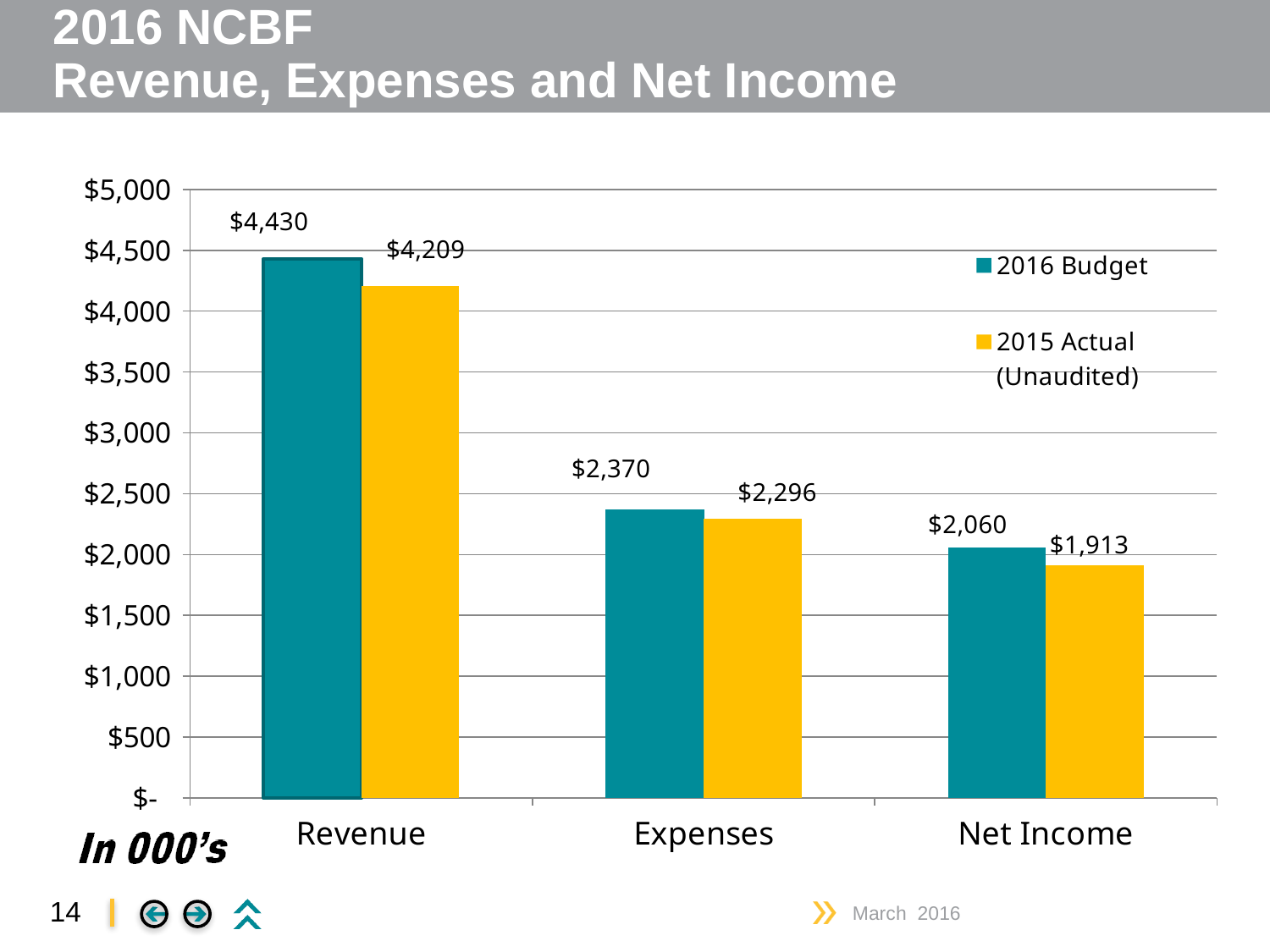
Which category has the highest 2016 Budget value? Revenue What is the 2016 Budget value for Net Income? $2,060 What is the difference between the 2016 Budget and 2015 Actual (Unaudited) values for Revenue? $221 How many categories are shown on the x axis? 3 Which is larger for Expenses: the 2016 Budget or the 2015 Actual (Unaudited) value? 2016 Budget What is the difference between the 2016 Budget and 2015 Actual (Unaudited) values for Net Income? $147 What is the 2016 Budget value for Revenue? $4,430 What colour represents the 2015 Actual (Unaudited) series? Yellow What kind of chart is shown on the slide? Bar chart What is the 2015 Actual (Unaudited) value for Expenses? $2,296 Which category has the lowest 2015 Actual (Unaudited) value? Net Income How many series does the legend list? 2